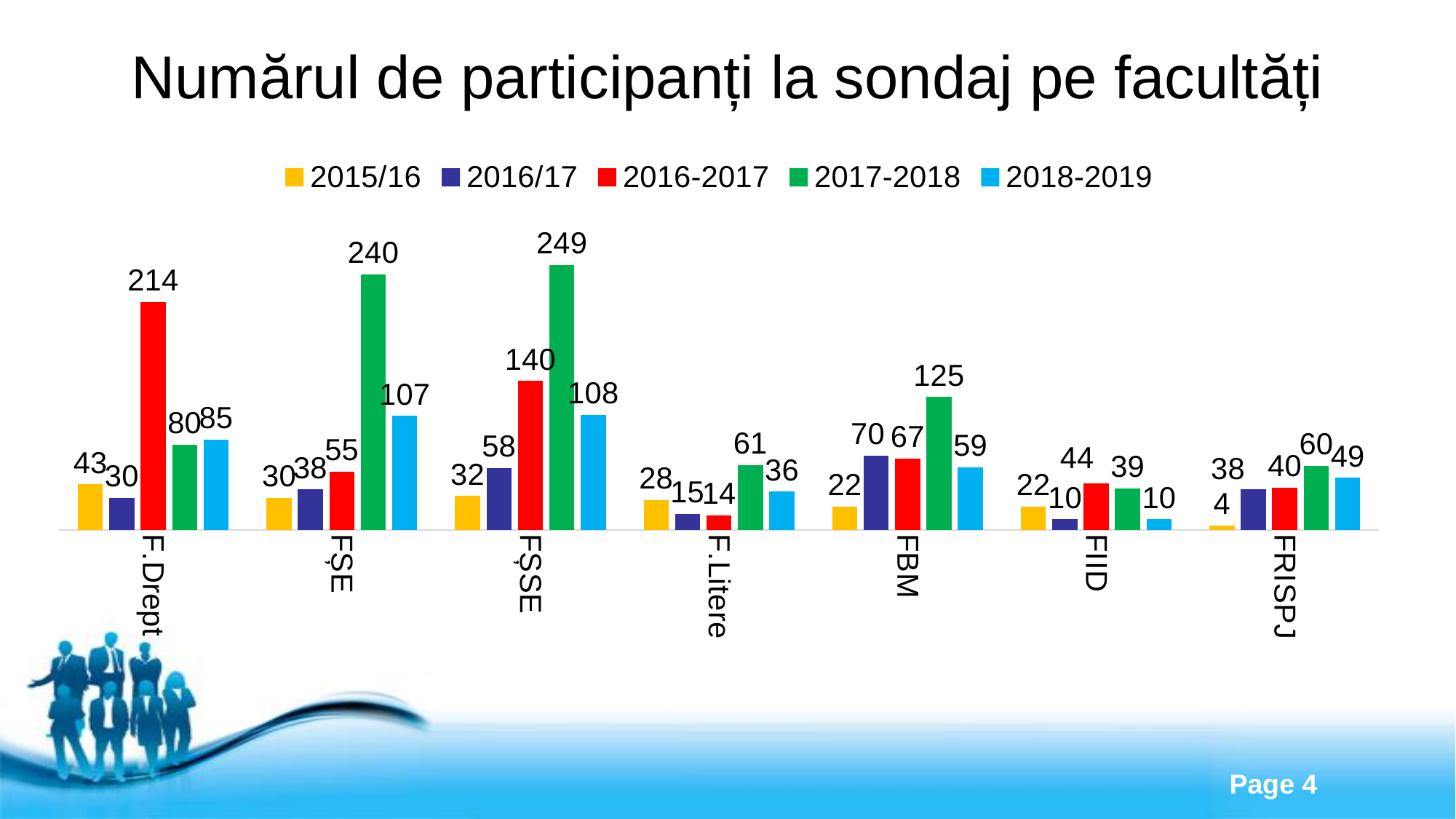
Which faculty has the highest value in the 2017-2018 series? FȘSE What is the difference between the 2018-2019 values for FȘE and F.Drept? 22 What is the value for FRISPJ in the 2015/16 series? 4 What is the value for F.Drept in the 2016-2017 series? 214 Which is larger for F.Litere: the 2016/17 value or the 2016-2017 value? 2016/17 What is the title of the chart? Numărul de participanți la sondaj pe facultăți How many faculties (categories) are shown on the x axis? 7 What is the difference between the 2017-2018 values for FȘSE and FȘE? 9 What is the value for FBM in the 2017-2018 series? 125 How many series does the legend list? 5 Which faculty has the lowest value in the 2015/16 series? FRISPJ What type of chart is shown on the slide? bar chart